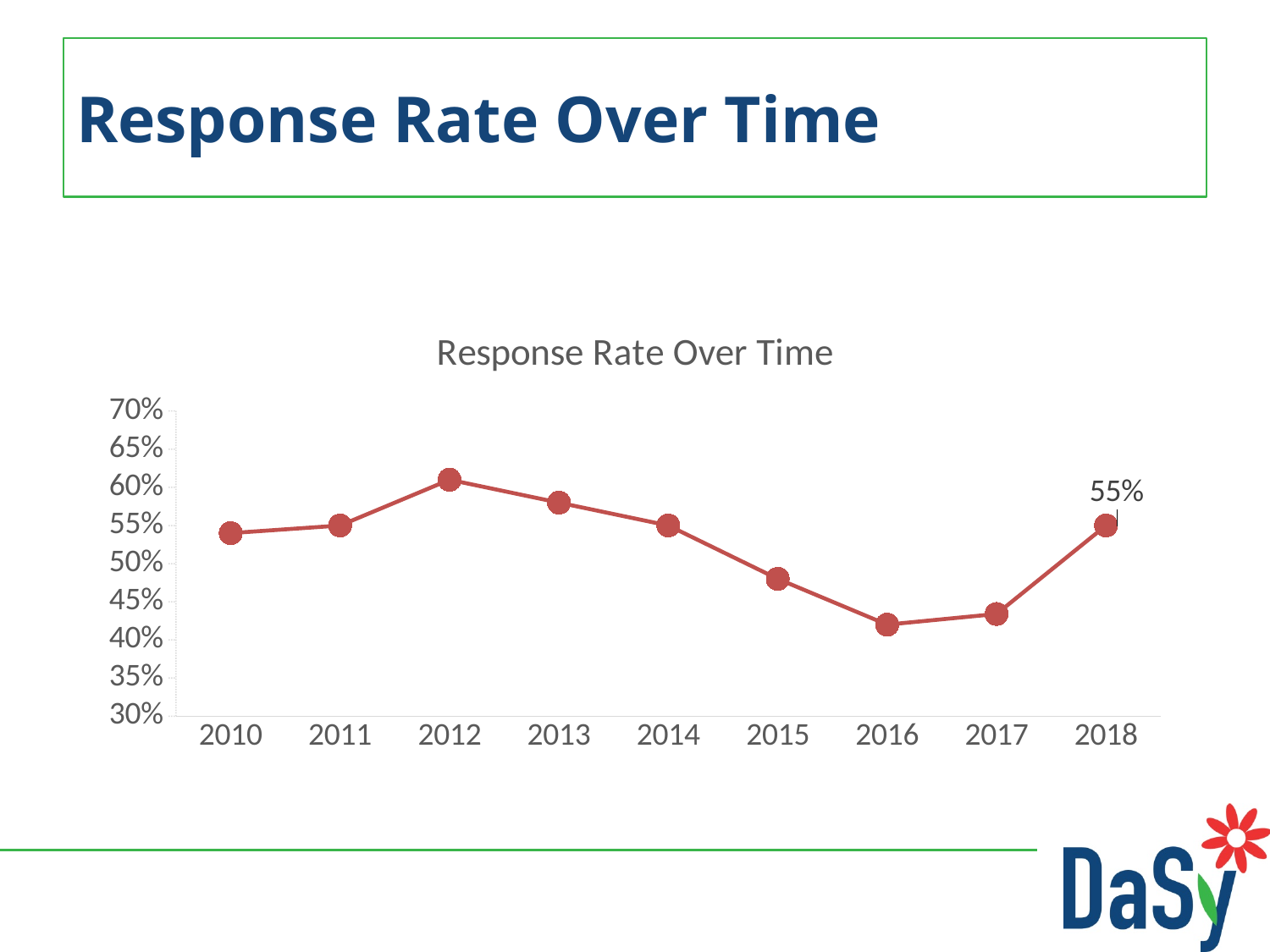
Does the response rate rise or fall from 2012 to 2016? Fall Is the response rate for 2013 greater or less than 55%? greater Is the response rate for 2015 greater or less than 50%? less Which year has the highest response rate? 2012 What is the title of the chart? Response Rate Over Time What is the response rate for 2018? 55% Is the response rate for 2012 greater or less than 55%? greater Which year has the larger response rate, 2013 or 2015? 2013 What kind of chart is shown on the slide? Line chart Which year has the larger response rate, 2012 or 2016? 2012 How many years are plotted on the chart? 9